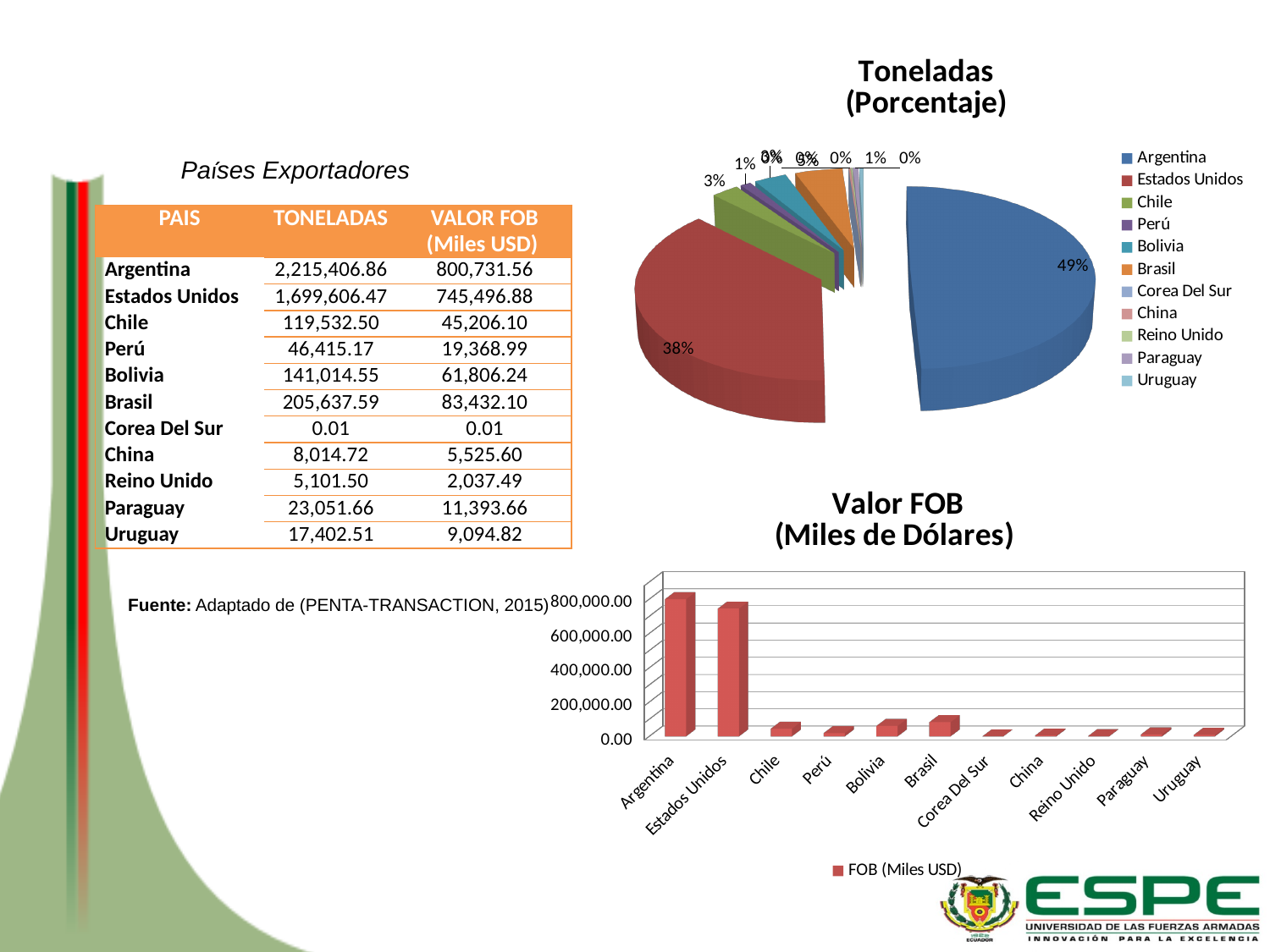
How many series does the legend of the Valor FOB (Miles de Dólares) bar chart list? 1 In the Valor FOB (Miles de Dólares) bar chart, which country has the tallest bar? Argentina In the Toneladas (Porcentaje) pie chart, which country has the largest slice? Argentina How many countries are listed in the legend of the Toneladas (Porcentaje) pie chart? 11 In the Valor FOB (Miles de Dólares) bar chart, is the value for Argentina greater or less than 600,000.00? greater What kind of chart is the Valor FOB (Miles de Dólares) chart? Bar chart In the Toneladas (Porcentaje) pie chart, what is the difference in percentage points between the Argentina and Estados Unidos slices? 11 In the Toneladas (Porcentaje) pie chart, what share of the pie does Argentina hold? 49% In the Valor FOB (Miles de Dólares) bar chart, is the value for Chile greater or less than 200,000.00? less In the Valor FOB (Miles de Dólares) bar chart, which bar is taller, Brasil or Perú? Brasil In the Toneladas (Porcentaje) pie chart, what share of the pie does Estados Unidos hold? 38% In the Toneladas (Porcentaje) pie chart, which slice is larger, Argentina or Estados Unidos? Argentina